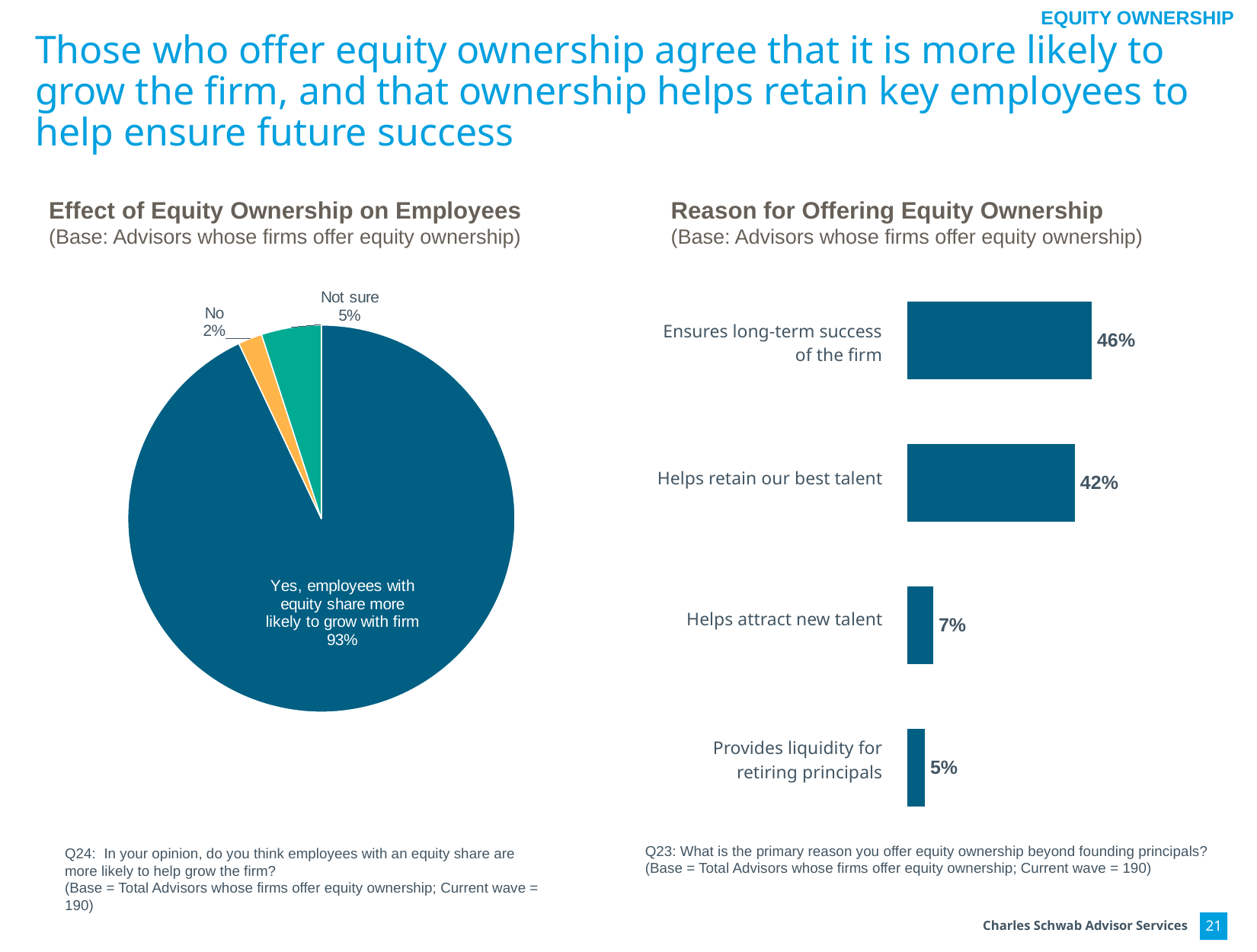
In the 'Reason for Offering Equity Ownership' chart, which reason has the highest value? Ensures long-term success of the firm In the 'Reason for Offering Equity Ownership' chart, what is the value for 'Helps retain our best talent'? 42% What kind of chart is 'Effect of Equity Ownership on Employees'? Pie chart In the 'Reason for Offering Equity Ownership' chart, which reason has the lowest value? Provides liquidity for retiring principals In the 'Reason for Offering Equity Ownership' chart, what is the difference between 'Ensures long-term success of the firm' and 'Helps retain our best talent'? 4% How many slices does the 'Effect of Equity Ownership on Employees' pie chart have? 3 In the 'Effect of Equity Ownership on Employees' chart, which slice is the largest? Yes, employees with equity share more likely to grow with firm What kind of chart is 'Reason for Offering Equity Ownership'? Bar chart In the 'Reason for Offering Equity Ownership' chart, which is larger: 'Helps attract new talent' or 'Provides liquidity for retiring principals'? Helps attract new talent How many categories are shown in the 'Reason for Offering Equity Ownership' chart? 4 In the 'Effect of Equity Ownership on Employees' chart, what percentage answered 'No'? 2% In the 'Effect of Equity Ownership on Employees' chart, what share of the pie is 'Not sure'? 5%